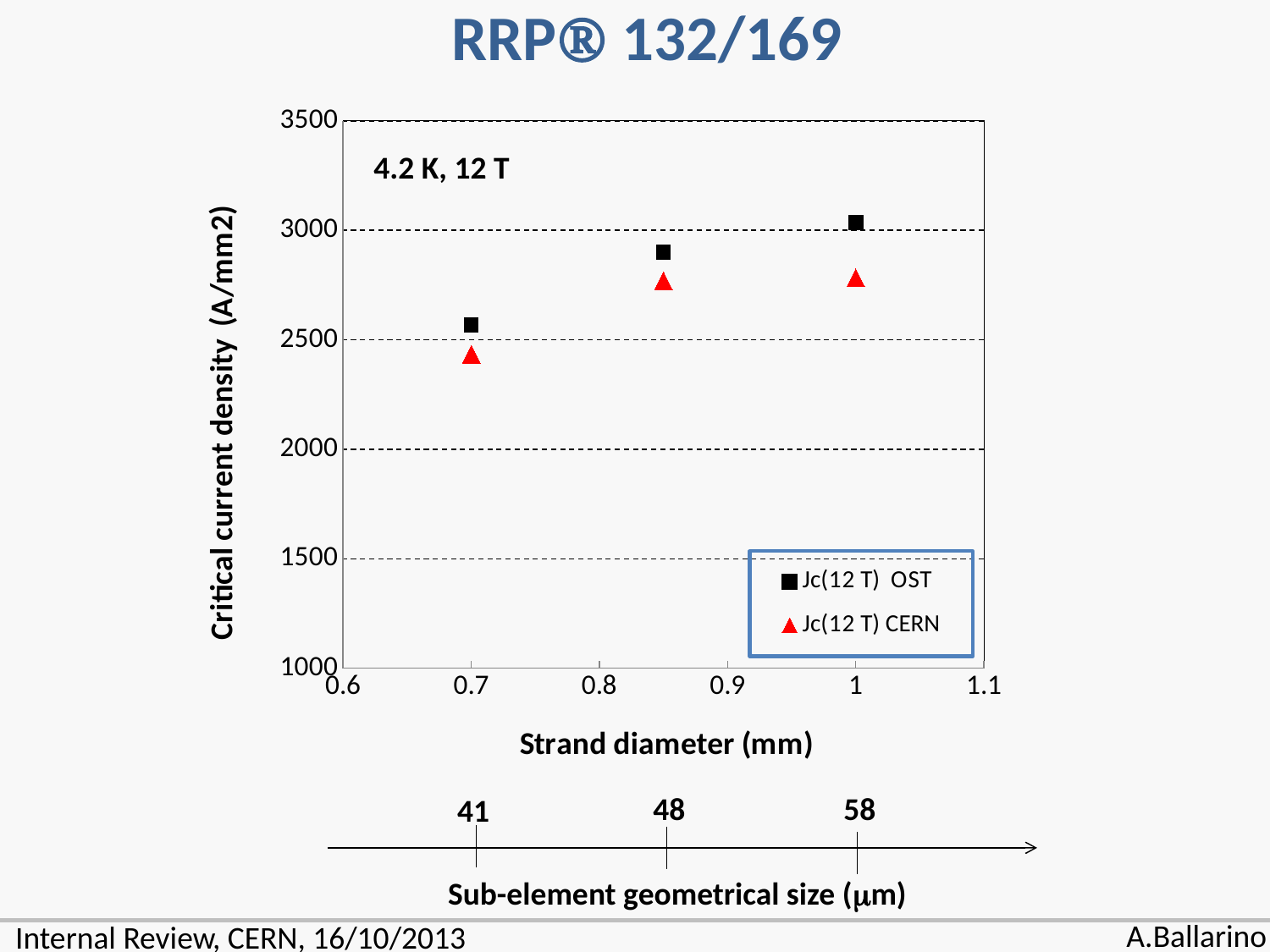
How many data points are plotted for the Jc(12 T) OST series? 3 At which strand diameter is the Jc(12 T) OST value highest? 1 mm How many series does the legend list? 2 What kind of chart is shown on the slide? scatter plot Is the Jc(12 T) CERN value at a strand diameter of 1 mm greater or less than 3000? less At a strand diameter of 0.7 mm, which series has the larger critical current density, Jc(12 T) OST or Jc(12 T) CERN? Jc(12 T) OST Is the Jc(12 T) CERN value at a strand diameter of 0.7 mm greater or less than 2500? less Is the Jc(12 T) CERN value at a strand diameter of 0.85 mm greater or less than 2500? greater At which strand diameter is the Jc(12 T) CERN value lowest? 0.7 mm Do the Jc(12 T) OST values rise or fall as strand diameter increases? rise What measurement conditions are annotated inside the plot area? 4.2 K, 12 T